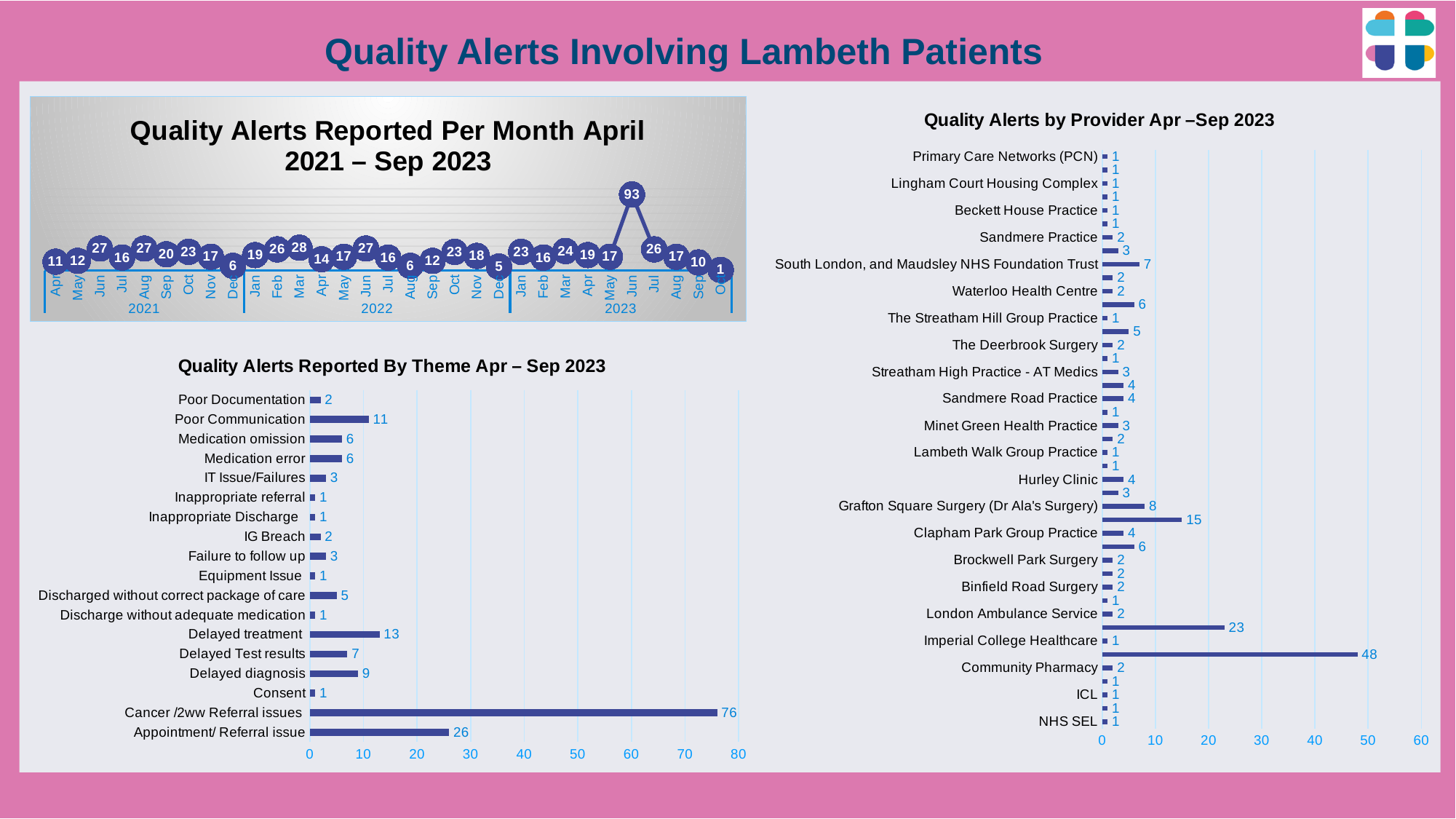
In the 'Quality Alerts Reported Per Month April 2021 – Sep 2023' chart, what is the difference between the values for Jun 2023 and Jul 2023? 67 In the 'Quality Alerts Reported By Theme Apr – Sep 2023' chart, which is larger: Delayed treatment or Delayed diagnosis? Delayed treatment In the 'Quality Alerts Reported By Theme Apr – Sep 2023' chart, which theme has the highest value? Cancer /2ww Referral issues In the 'Quality Alerts Reported Per Month April 2021 – Sep 2023' chart, which month has the highest number of alerts? Jun 2023 In the 'Quality Alerts Reported Per Month April 2021 – Sep 2023' chart, how many quality alerts were reported in Jun 2023? 93 In the 'Quality Alerts by Provider Apr –Sep 2023' chart, what is the value for Grafton Square Surgery (Dr Ala's Surgery)? 8 In the 'Quality Alerts by Provider Apr –Sep 2023' chart, what is the value for South London, and Maudsley NHS Foundation Trust? 7 What type of chart is 'Quality Alerts by Provider Apr –Sep 2023'? Bar chart In the 'Quality Alerts Reported By Theme Apr – Sep 2023' chart, what is the value for Cancer /2ww Referral issues? 76 What type of chart is 'Quality Alerts Reported Per Month April 2021 – Sep 2023'? Line chart In the 'Quality Alerts Reported By Theme Apr – Sep 2023' chart, how many themes are listed? 18 In the 'Quality Alerts Reported By Theme Apr – Sep 2023' chart, what is the difference between Appointment/ Referral issue and Poor Communication? 15